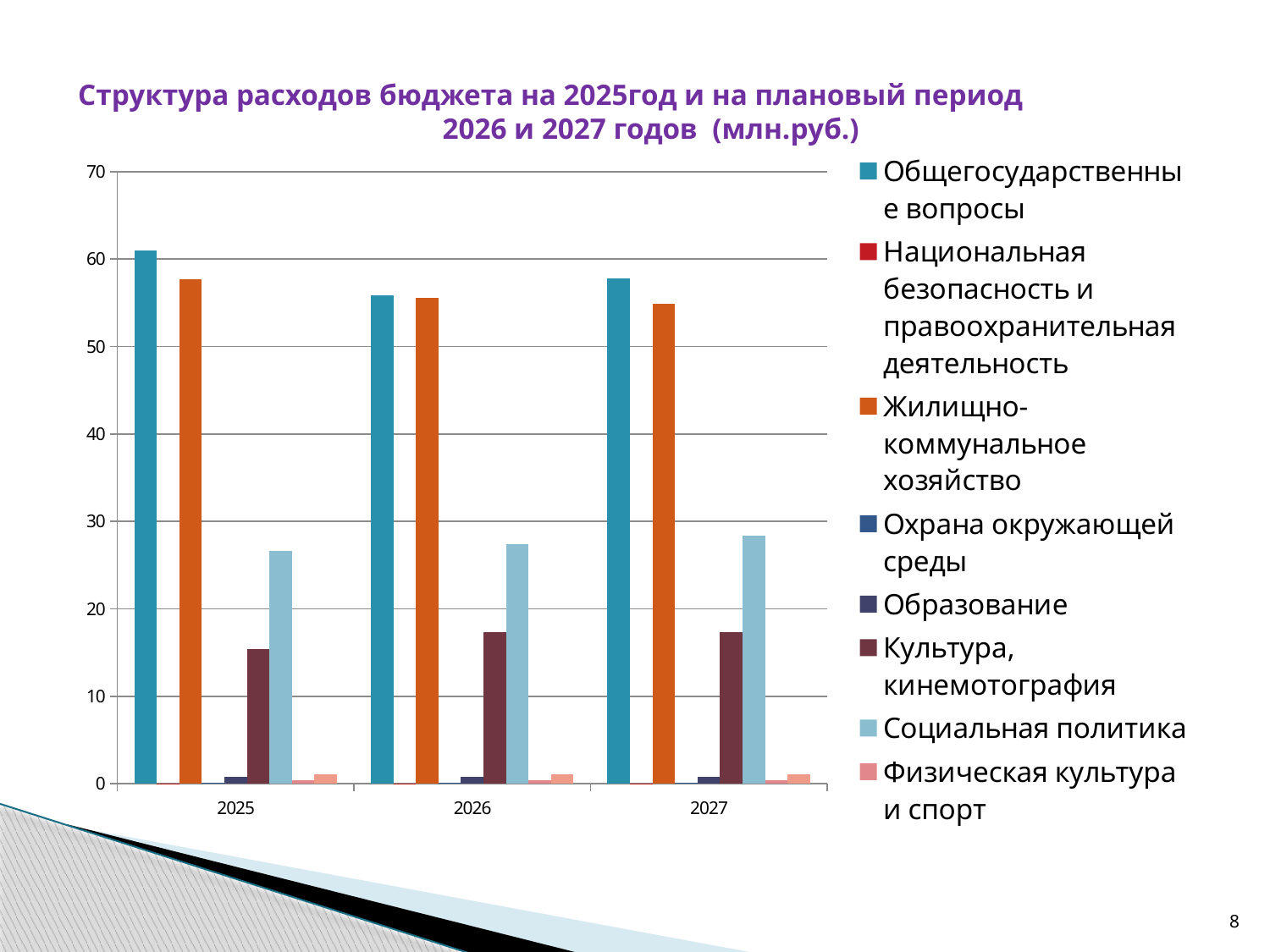
In 2027, which is larger: Общегосударственные вопросы or Жилищно-коммунальное хозяйство? Общегосударственные вопросы Is the value for Культура, кинемотография in 2026 greater or less than 10? greater What kind of chart is shown on the slide? bar chart What unit is given in the chart title? млн.руб. Which series has the highest value in 2025? Общегосударственные вопросы How many years (categories) are shown on the x axis? 3 Does the value for Социальная политика rise or fall from 2025 to 2027? rise Is the value for Жилищно-коммунальное хозяйство in 2027 greater or less than 60? less How many series does the legend list? 8 Is the value for Социальная политика in 2025 greater or less than 30? less In 2026, which is larger: Социальная политика or Культура, кинемотография? Социальная политика